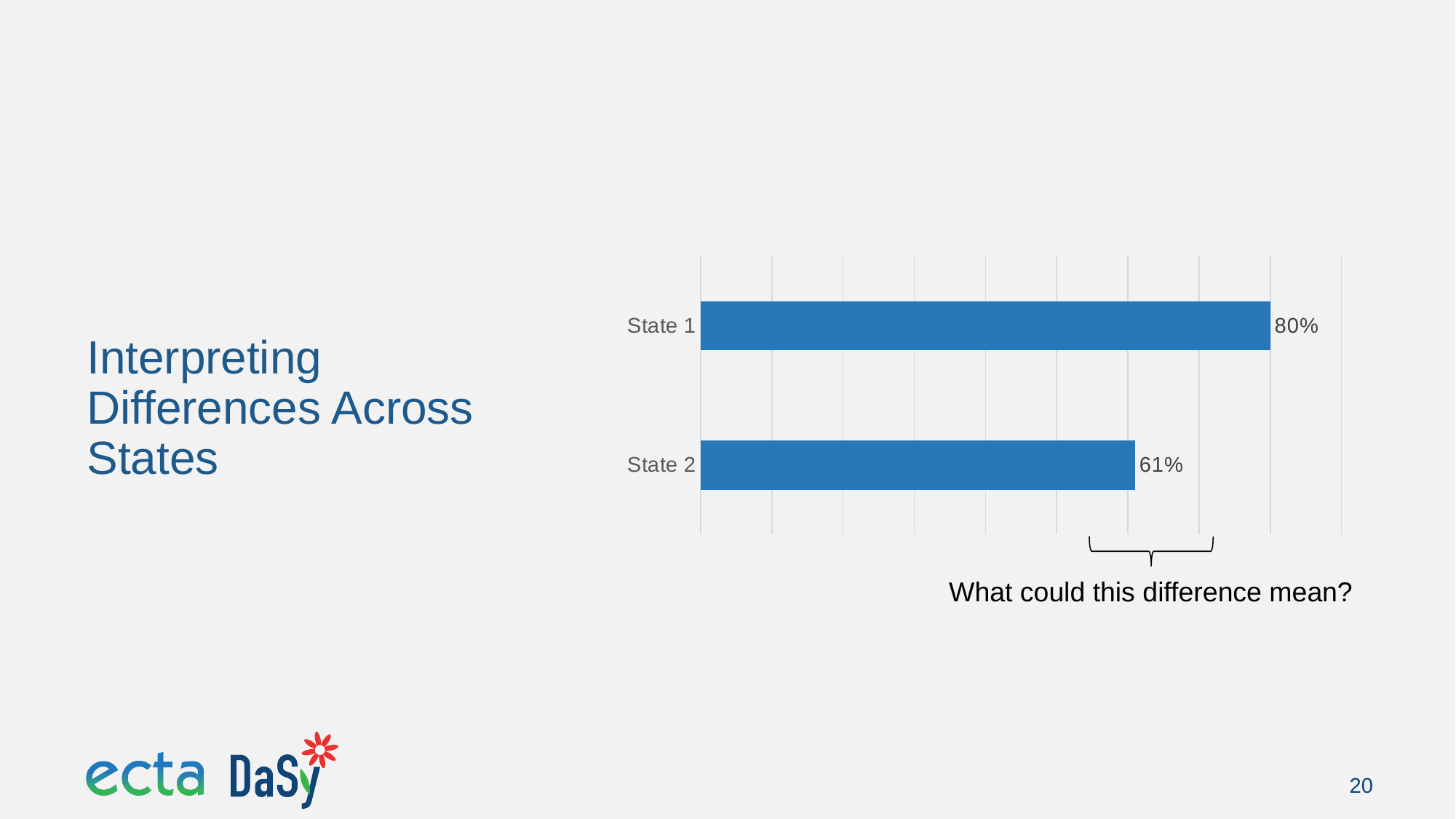
Which is larger, the value for State 1 or the value for State 2? State 1 What is the value for State 2? 61% What question is written below the chart? What could this difference mean? Which state has the lowest value? State 2 What kind of chart is shown on the slide? Bar chart What is the title of the slide containing the chart? Interpreting Differences Across States Which state has the highest value? State 1 How many states are shown in the chart? 2 What is the difference between the values for State 1 and State 2? 19% What is the value for State 1? 80%